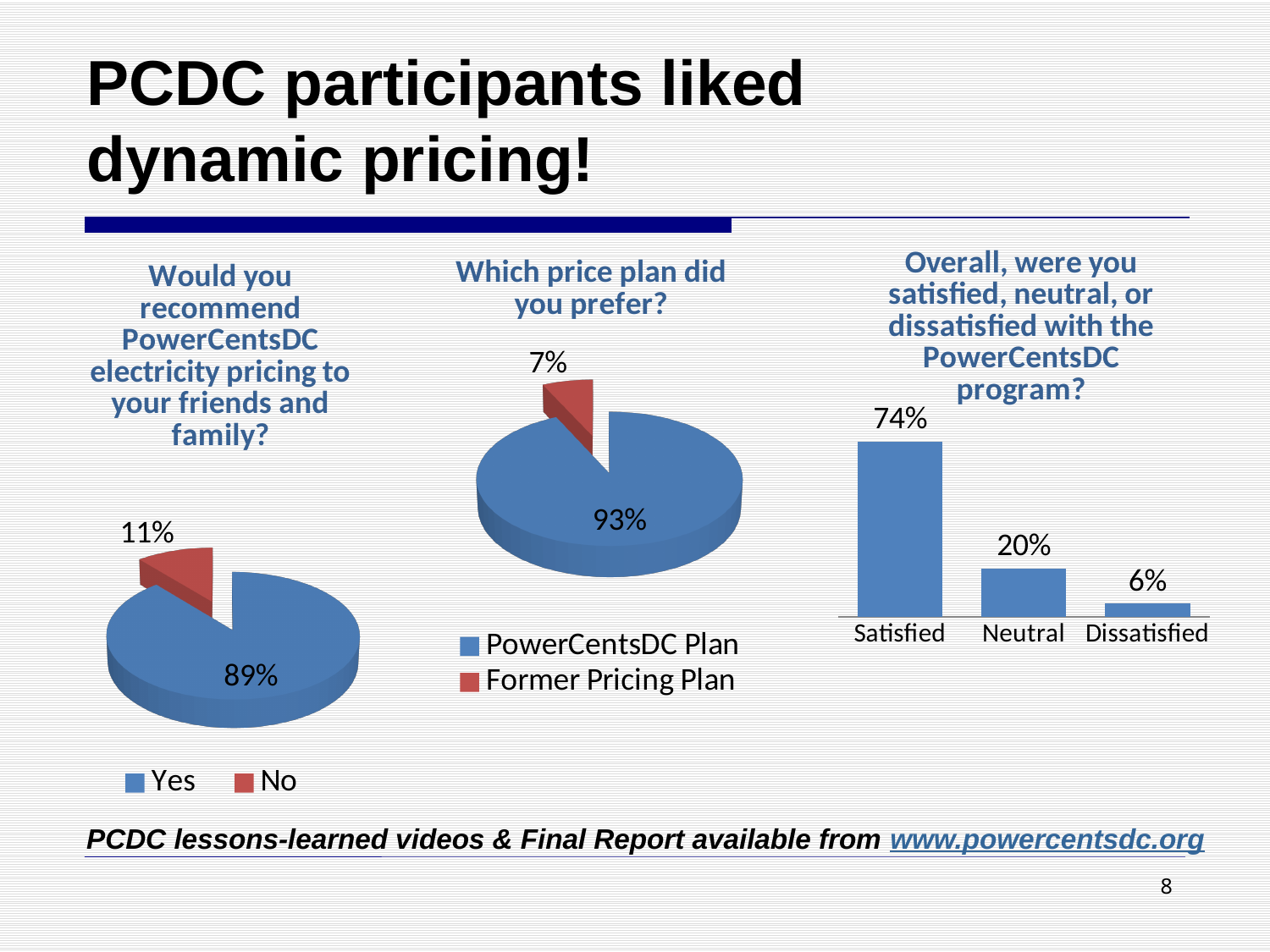
In the 'Overall, were you satisfied, neutral, or dissatisfied with the PowerCentsDC program?' chart, what is the difference between Satisfied and Neutral? 54% In the 'Overall, were you satisfied, neutral, or dissatisfied with the PowerCentsDC program?' chart, which category has the lowest value? Dissatisfied How many categories are shown in the 'Overall, were you satisfied, neutral, or dissatisfied with the PowerCentsDC program?' chart? 3 In the 'Which price plan did you prefer?' chart, what is the difference between the PowerCentsDC Plan share and the Former Pricing Plan share? 86% In the 'Which price plan did you prefer?' chart, what share preferred the Former Pricing Plan? 7% In the 'Would you recommend PowerCentsDC electricity pricing to your friends and family?' chart, what percentage answered No? 11% What kind of chart is the 'Overall, were you satisfied, neutral, or dissatisfied with the PowerCentsDC program?' chart? Bar chart In the 'Which price plan did you prefer?' chart, what share preferred the PowerCentsDC Plan? 93% In the 'Overall, were you satisfied, neutral, or dissatisfied with the PowerCentsDC program?' chart, what is the value for Neutral? 20% In the 'Would you recommend PowerCentsDC electricity pricing to your friends and family?' chart, what percentage answered Yes? 89% How many entries does the legend of the 'Which price plan did you prefer?' chart list? 2 In the 'Overall, were you satisfied, neutral, or dissatisfied with the PowerCentsDC program?' chart, which category has the highest value? Satisfied